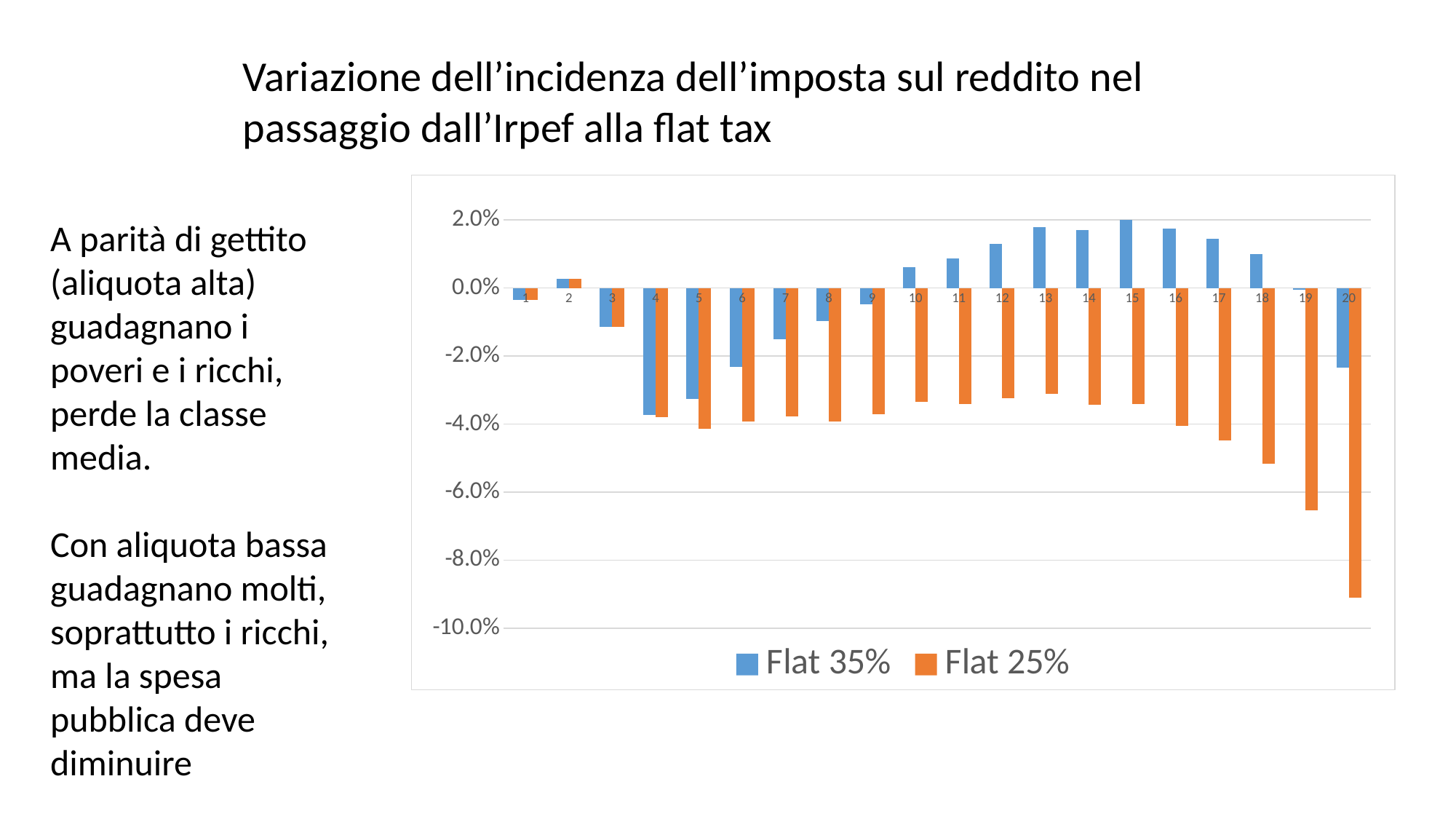
How many categories are plotted along the x axis? 20 For category 13, which series has the higher value, Flat 35% or Flat 25%? Flat 35% Is the Flat 25% value for category 20 greater or less than -8.0%? less Which category has the lowest value for the Flat 25% series? 20 Which category has the lowest value for the Flat 35% series? 4 What kind of chart is shown on the slide? Bar chart Which category has the highest value for the Flat 25% series? 2 Is the Flat 35% value for category 13 greater or less than 1.0%? greater Is the Flat 25% value for category 19 greater or less than -6.0%? less Do the Flat 25% values rise or fall from category 10 to category 20? Fall How many series does the legend list? 2 What colour are the bars for the Flat 25% series? Orange